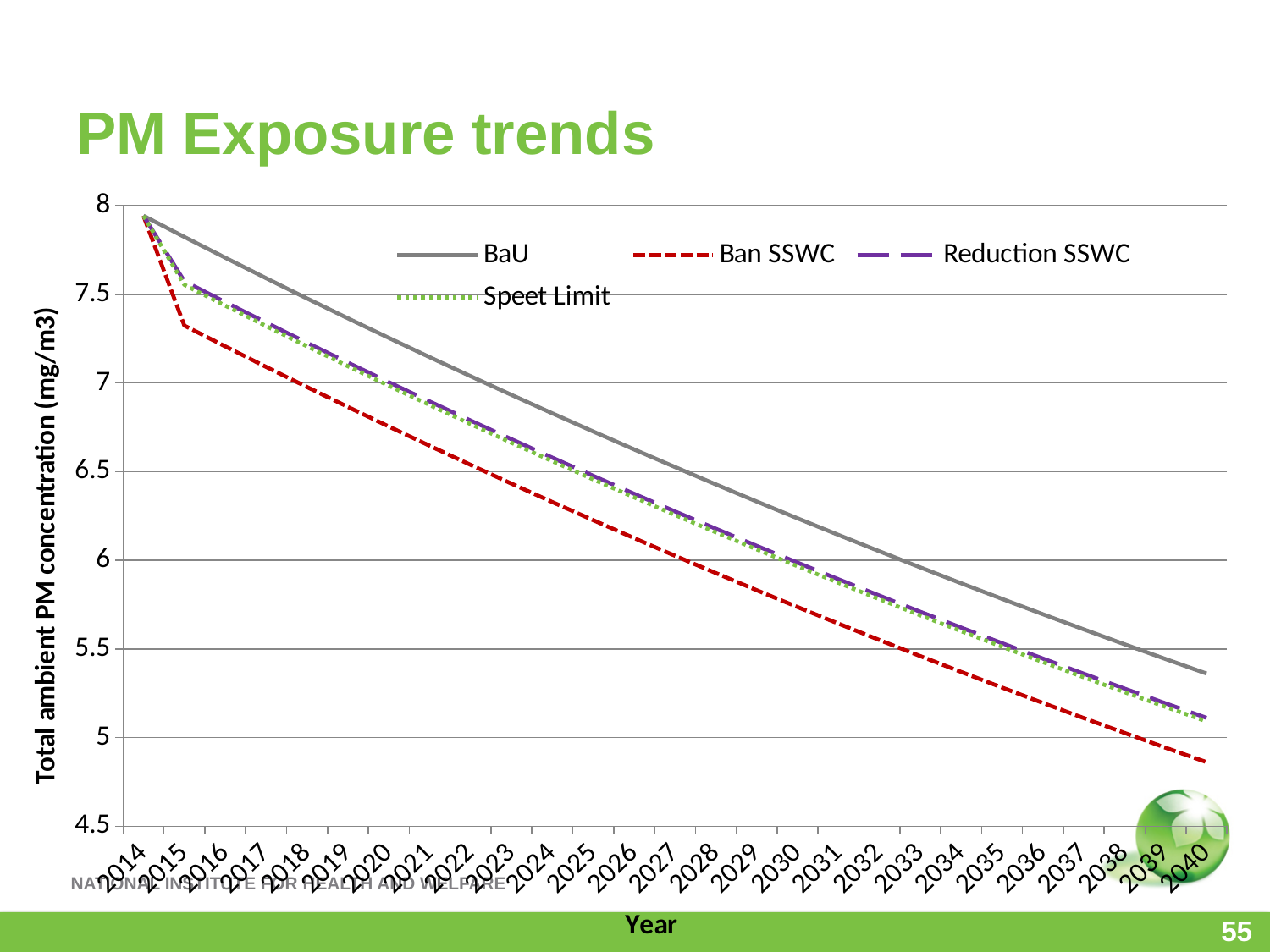
What is the title of the y axis? Total ambient PM concentration (mg/m3) In 2030, which is larger: the value for Ban SSWC or the value for Speet Limit? Speet Limit Is the value for Ban SSWC in 2040 greater or less than 5? less Which series has the highest value in 2040? BaU What kind of chart is shown on the slide? line chart Is the value for BaU in 2030 greater or less than 6? greater How many series does the legend list? 4 Which series has the lowest value in 2040? Ban SSWC How many years are shown along the x axis? 27 Do the values for BaU rise or fall from 2014 to 2040? fall Is the value for BaU in 2040 greater or less than 5.5? less